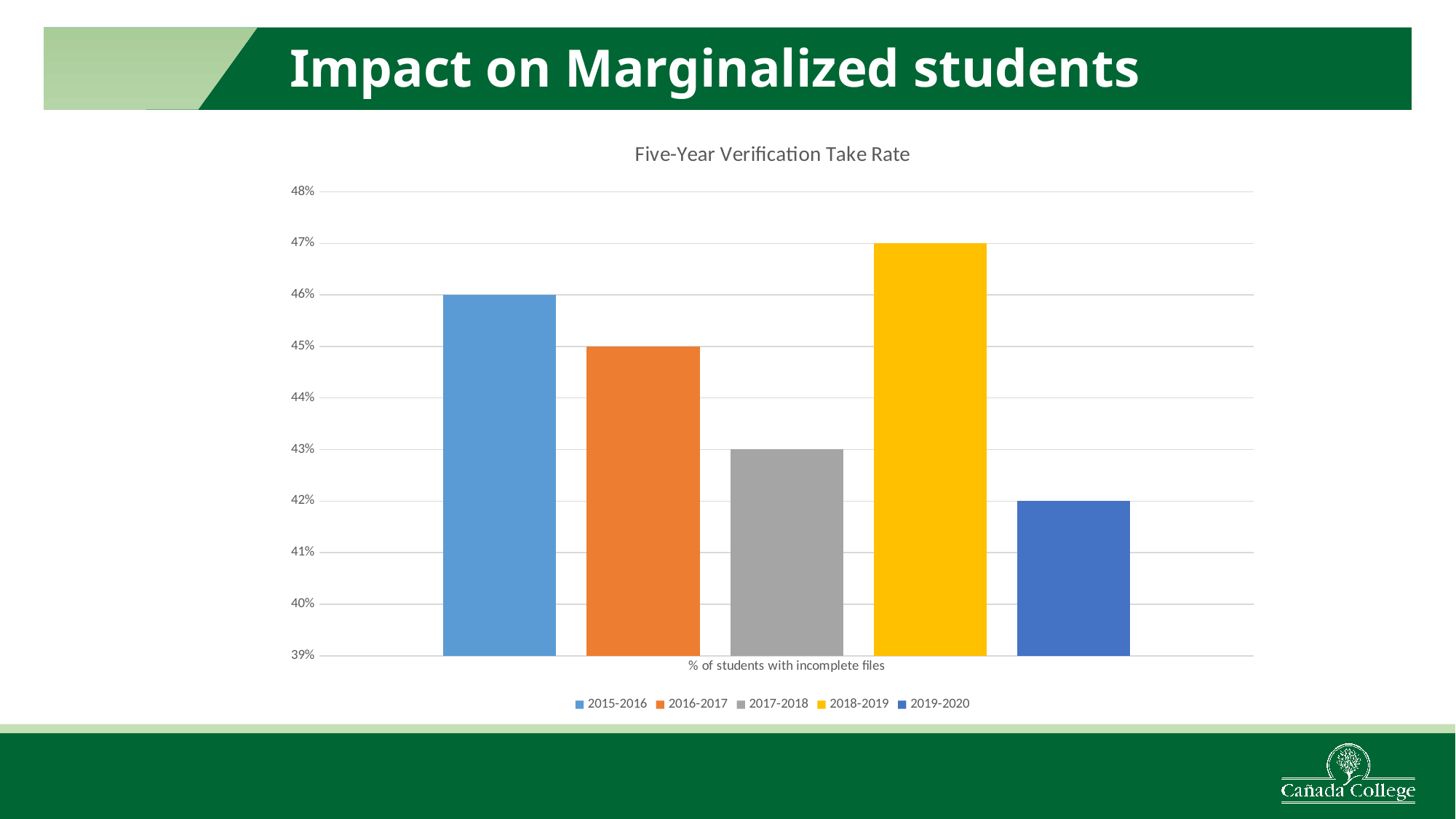
What is the value for 2017-2018 in the Five-Year Verification Take Rate chart? 43% What is the title of the chart? Five-Year Verification Take Rate Which year has the highest verification take rate? 2018-2019 Which is larger, the value for 2016-2017 or the value for 2017-2018? 2016-2017 What is the value for 2015-2016 in the Five-Year Verification Take Rate chart? 46% Is the value for 2016-2017 greater or less than 44%? greater What is the value for 2018-2019 in the Five-Year Verification Take Rate chart? 47% How many series does the legend list? 5 Which year has the lowest verification take rate? 2019-2020 What kind of chart is shown on the slide? Bar chart What is the value for 2019-2020 in the Five-Year Verification Take Rate chart? 42% What is the difference between the values for 2018-2019 and 2019-2020? 5%